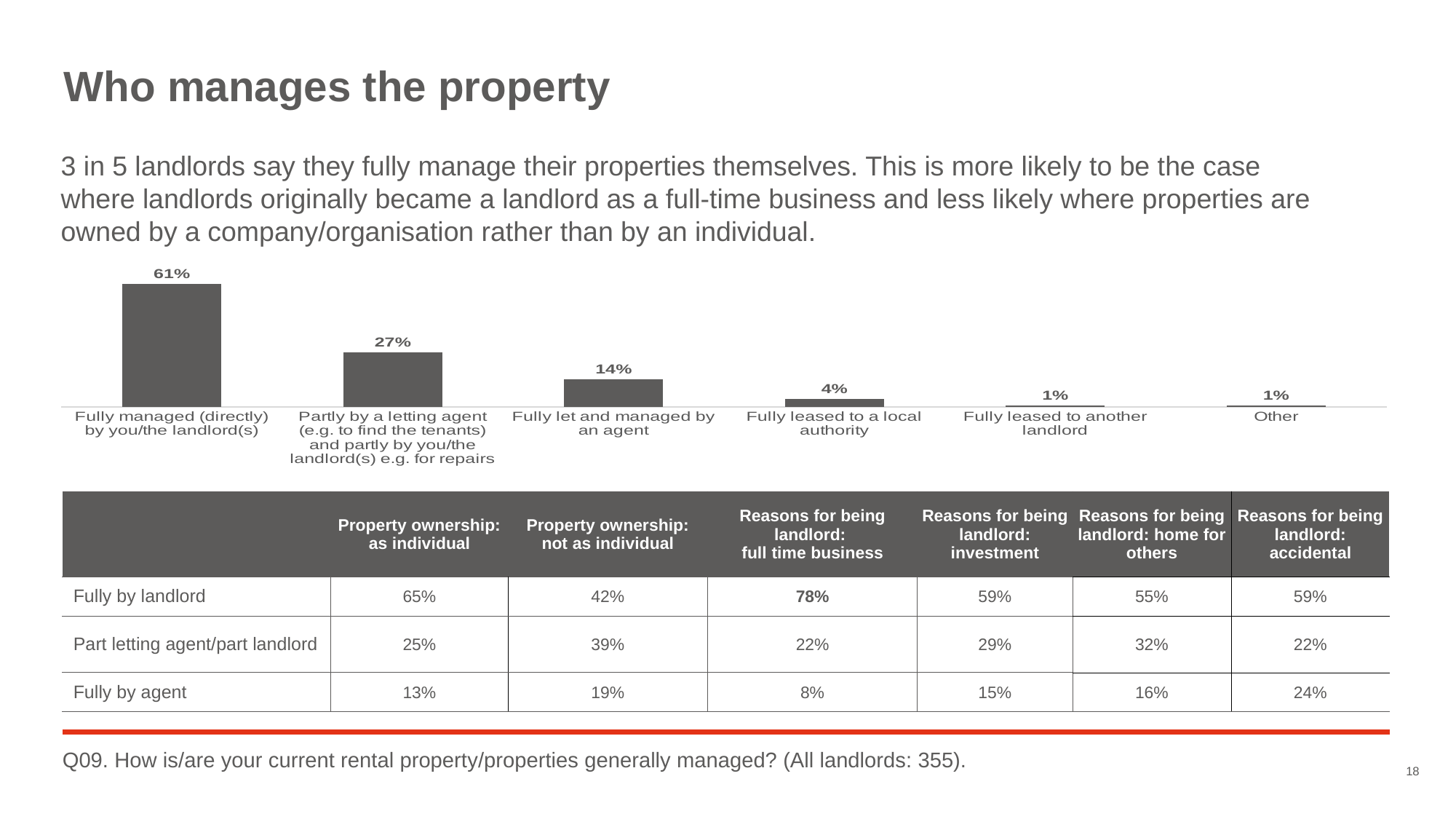
What is the value for 'Partly by a letting agent (e.g. to find the tenants) and partly by you/the landlord(s) e.g. for repairs'? 27% What is the difference between the 'Fully managed (directly) by you/the landlord(s)' bar and the 'Partly by a letting agent...' bar? 34 percentage points What type of chart is shown on the slide? Bar chart Do the values rise or fall moving from left to right across the chart? Fall What is the value for 'Other' in the chart? 1% What percentage of landlords say their property is fully managed (directly) by you/the landlord(s)? 61% Which category has the highest value in the chart? Fully managed (directly) by you/the landlord(s) Which is larger: 'Fully let and managed by an agent' or 'Fully leased to a local authority'? Fully let and managed by an agent What is the value for 'Fully leased to a local authority'? 4% What percentage of landlords have their property fully let and managed by an agent? 14% How many categories are shown in the bar chart? 6 What is the difference between 'Fully let and managed by an agent' and 'Fully leased to a local authority'? 10 percentage points